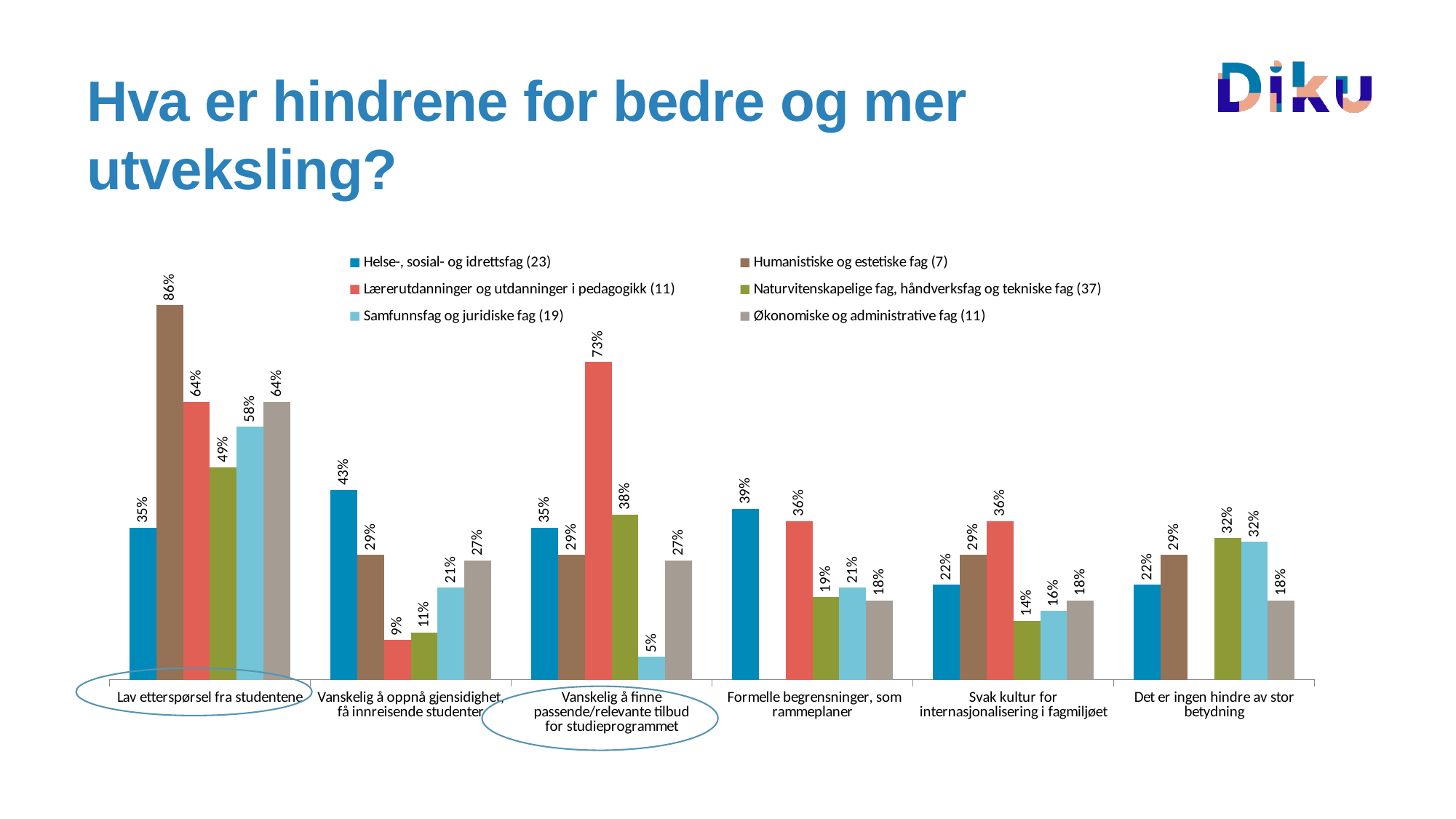
What is the value for Humanistiske og estetiske fag (7) in the category 'Lav etterspørsel fra studentene'? 86% In which category does Samfunnsfag og juridiske fag (19) have its lowest value? Vanskelig å finne passende/relevante tilbud for studieprogrammet What kind of chart is shown on the slide? Bar chart What is the difference between Lærerutdanninger og utdanninger i pedagogikk (11) and Naturvitenskapelige fag, håndverksfag og tekniske fag (37) in the category 'Vanskelig å finne passende/relevante tilbud for studieprogrammet'? 35 percentage points Which series has the highest value in the category 'Vanskelig å oppnå gjensidighet, få innreisende studenter'? Helse-, sosial- og idrettsfag (23) In the category 'Lav etterspørsel fra studentene', which is larger: Naturvitenskapelige fag, håndverksfag og tekniske fag (37) or Samfunnsfag og juridiske fag (19)? Samfunnsfag og juridiske fag (19) How many series does the legend list? 6 What is the value for Økonomiske og administrative fag (11) in the category 'Svak kultur for internasjonalisering i fagmiljøet'? 18% How many categories are shown on the x axis of the chart? 6 In which category does Helse-, sosial- og idrettsfag (23) have its highest value? Vanskelig å oppnå gjensidighet, få innreisende studenter What is the difference between Humanistiske og estetiske fag (7) and Helse-, sosial- og idrettsfag (23) in the category 'Lav etterspørsel fra studentene'? 51 percentage points What is the value for Lærerutdanninger og utdanninger i pedagogikk (11) in the category 'Vanskelig å finne passende/relevante tilbud for studieprogrammet'? 73%